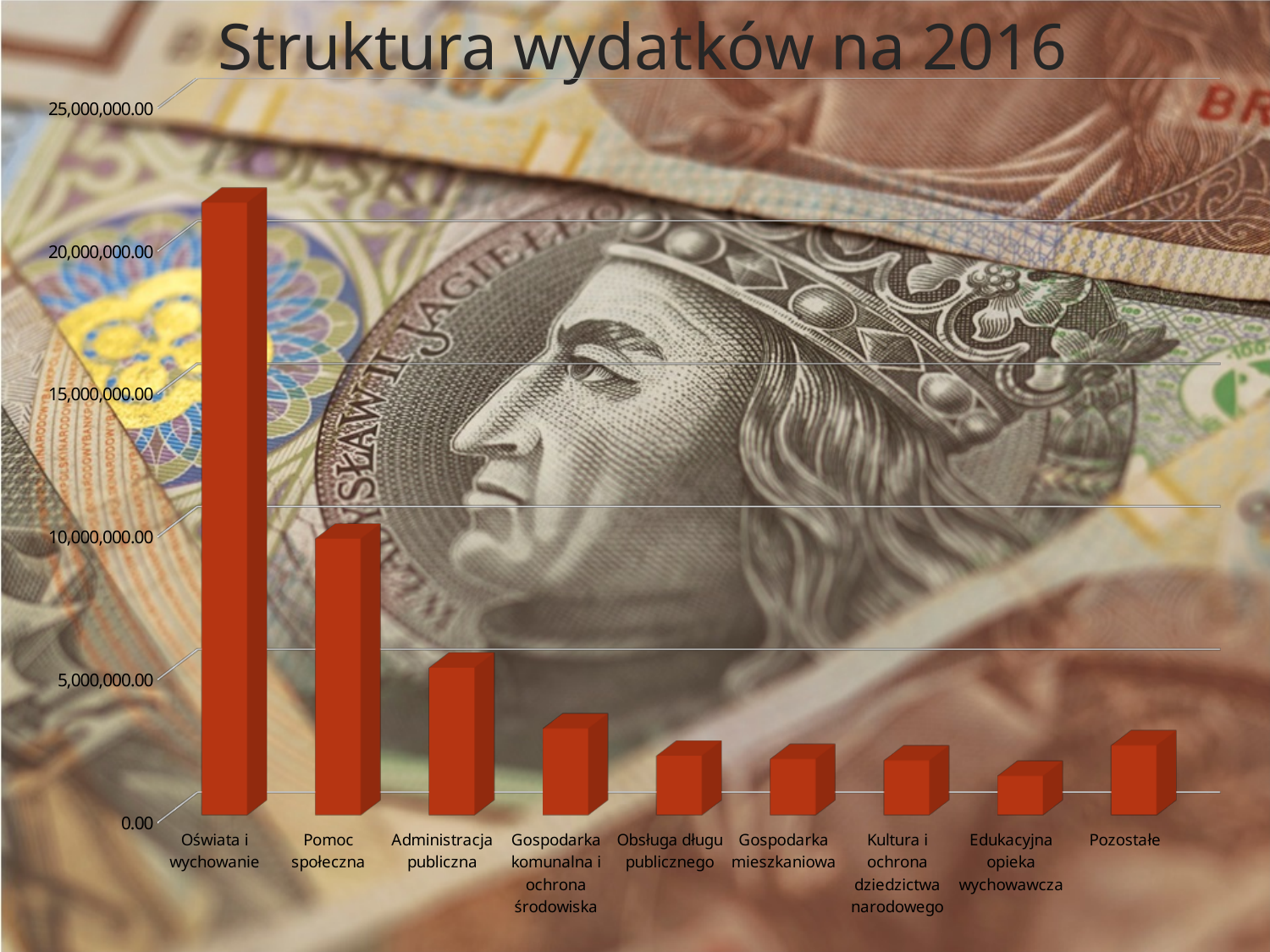
How many categories are shown on the x axis of the chart? 9 Do the values rise or fall from Oświata i wychowanie to Edukacyjna opieka wychowawcza along the x axis? fall Which is larger, the value for Pomoc społeczna or the value for Administracja publiczna? Pomoc społeczna Is the value for Pozostałe greater or less than 5,000,000.00? less Which is larger, the value for Gospodarka komunalna i ochrona środowiska or the value for Obsługa długu publicznego? Gospodarka komunalna i ochrona środowiska Which category has the highest value in the chart? Oświata i wychowanie What kind of chart is shown on the slide? bar chart Which is larger, the value for Pozostałe or the value for Edukacyjna opieka wychowawcza? Pozostałe Is the value for Gospodarka komunalna i ochrona środowiska greater or less than 5,000,000.00? less Is the value for Oświata i wychowanie greater or less than 20,000,000.00? greater Which category has the lowest value in the chart? Edukacyjna opieka wychowawcza What is the title of the chart? Struktura wydatków na 2016